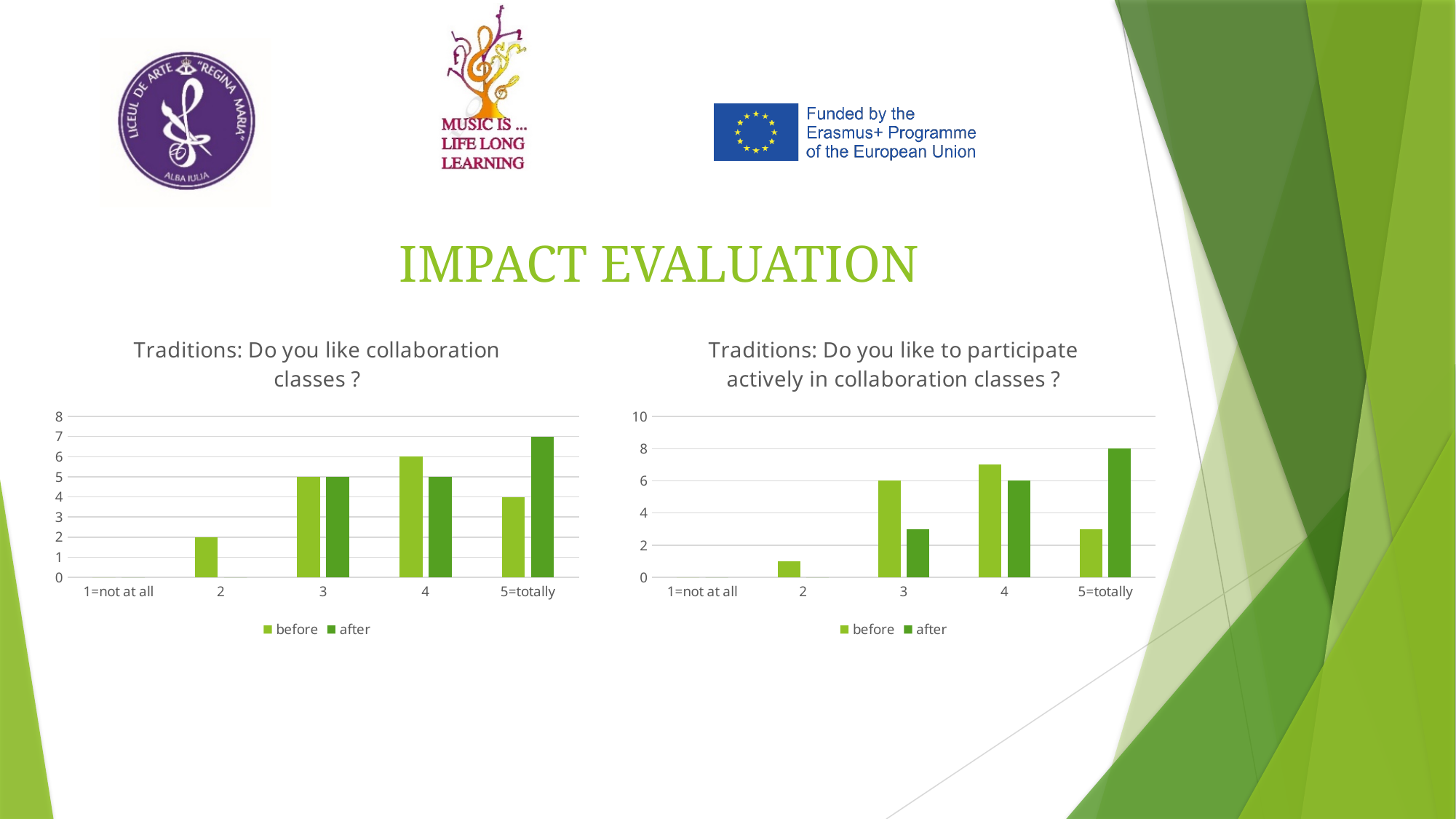
On the left chart 'Traditions: Do you like collaboration classes ?', what is the difference between the 'after' and 'before' values for '5=totally'? 3 On the left chart 'Traditions: Do you like collaboration classes ?', what is the 'after' value for '5=totally'? 7 How many series does the legend of the right chart 'Traditions: Do you like to participate actively in collaboration classes ?' list? 2 On the left chart 'Traditions: Do you like collaboration classes ?', is the 'before' value for category 4 larger or the 'after' value? before On the left chart 'Traditions: Do you like collaboration classes ?', what is the 'before' value for category 4? 6 On the right chart 'Traditions: Do you like to participate actively in collaboration classes ?', what is the 'before' value for category 3? 6 On the right chart 'Traditions: Do you like to participate actively in collaboration classes ?', what is the 'after' value for '5=totally'? 8 What kind of chart is the left chart 'Traditions: Do you like collaboration classes ?'? bar chart On the left chart 'Traditions: Do you like collaboration classes ?', what is the 'before' value for category 2? 2 On the right chart 'Traditions: Do you like to participate actively in collaboration classes ?', is the 'before' value for category 4 greater or less than 6? greater On the left chart 'Traditions: Do you like collaboration classes ?', which category has the highest 'after' value? 5=totally On the right chart 'Traditions: Do you like to participate actively in collaboration classes ?', which category has the highest 'after' value? 5=totally